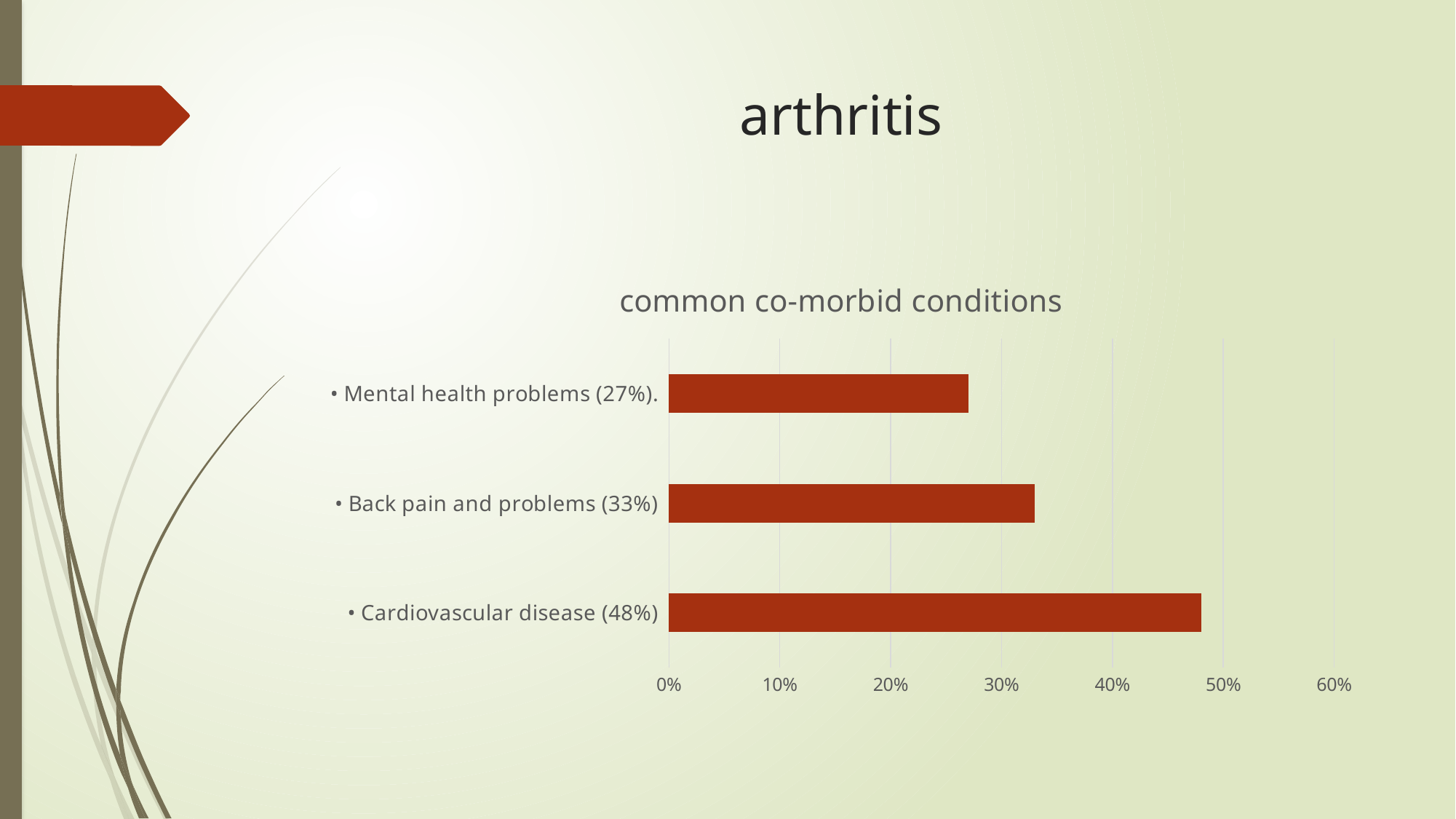
How many categories does the chart show? 3 Which category has the highest value? Cardiovascular disease What is the value for Cardiovascular disease? 48% What is the value for Mental health problems? 27% Which is larger, the value for Back pain and problems or the value for Mental health problems? Back pain and problems What is the difference between the values for Cardiovascular disease and Mental health problems? 21% Which category has the lowest value? Mental health problems Is the value for Cardiovascular disease greater or less than 40%? greater What is the value for Back pain and problems? 33% What is the difference between the values for Back pain and problems and Mental health problems? 6% What is the title of the chart? common co-morbid conditions What kind of chart is shown on the slide? bar chart